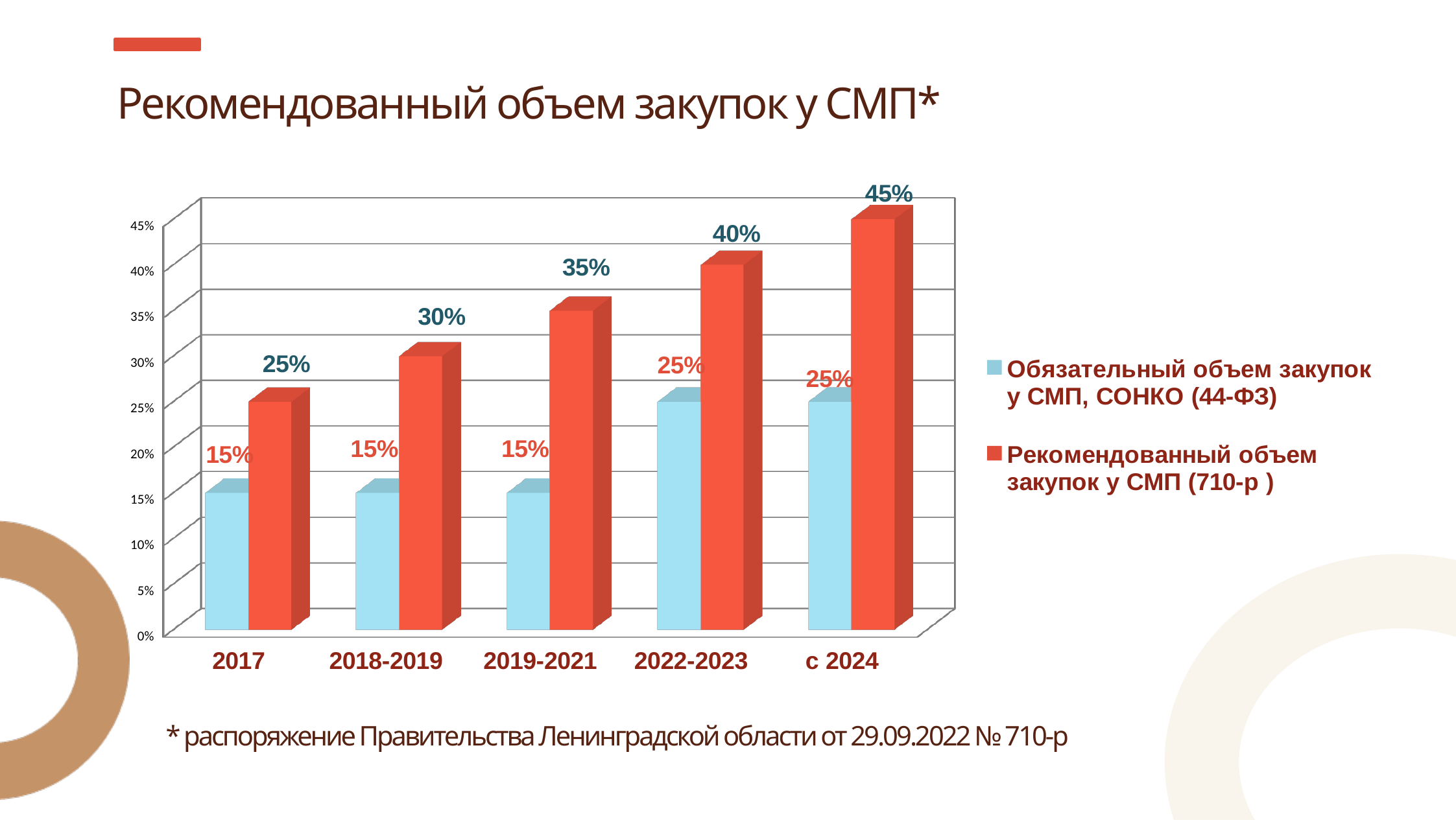
What is the mandatory purchase volume (44-ФЗ) for 2018-2019? 15% What is the difference between the recommended purchase volume (710-р) for 2022-2023 and for 2017? 15% How many periods are shown on the x axis? 5 In which period is the recommended purchase volume (710-р) lowest? 2017 What is the recommended purchase volume (710-р) for 2019-2021? 35% How many series does the legend list? 2 In which period is the recommended purchase volume (710-р) highest? с 2024 Which is larger: the recommended purchase volume (710-р) for 2018-2019 or the mandatory purchase volume (44-ФЗ) for с 2024? Recommended volume for 2018-2019 What is the recommended purchase volume (Рекомендованный объем закупок у СМП (710-р)) for 2017? 25% Does the recommended purchase volume (710-р) rise or fall from 2017 to с 2024? Rises What is the mandatory purchase volume (Обязательный объем закупок у СМП, СОНКО (44-ФЗ)) for 2022-2023? 25% What is the difference between the recommended (710-р) and mandatory (44-ФЗ) purchase volumes for с 2024? 20%